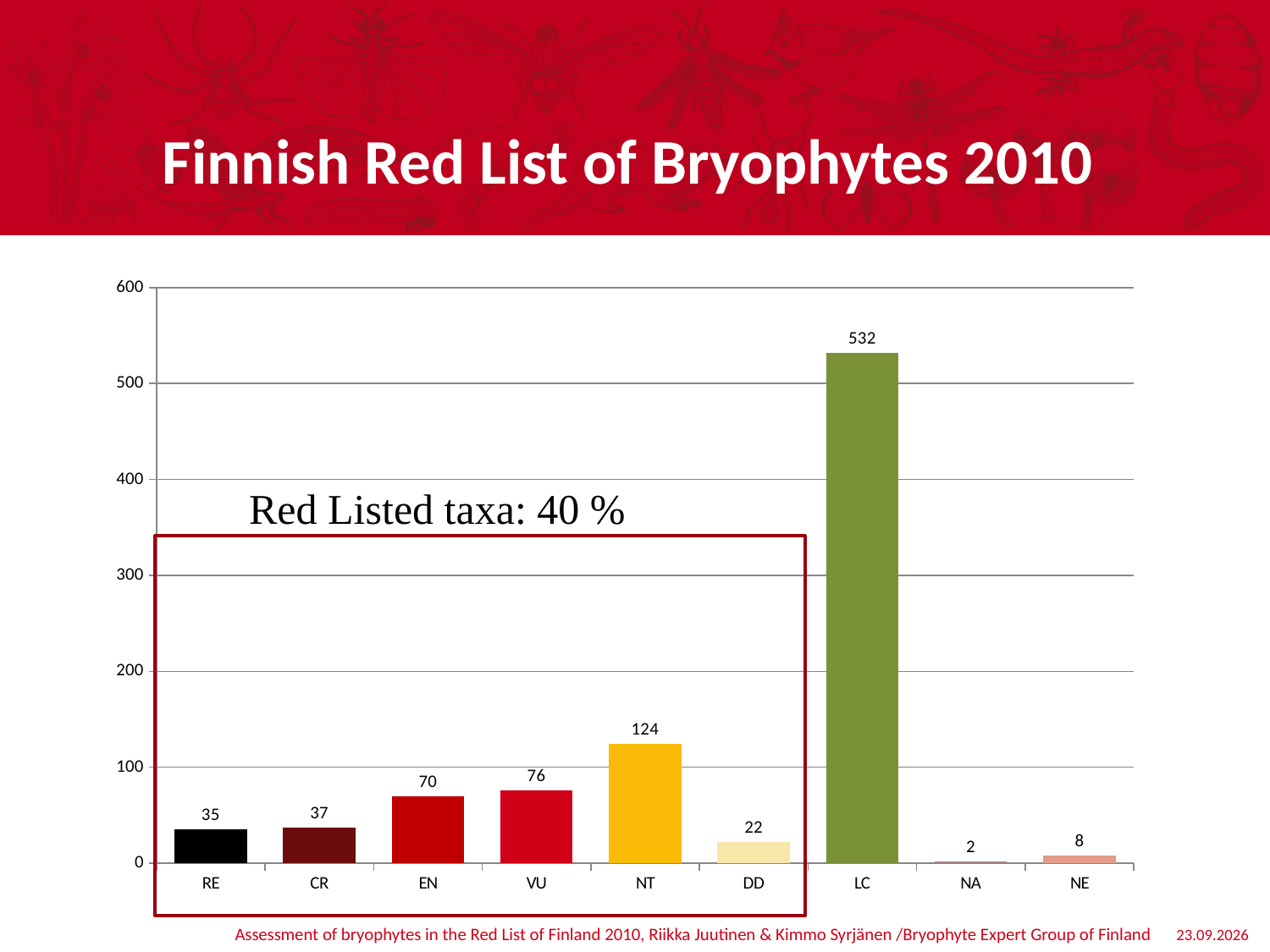
How many categories are shown on the x axis? 9 What is the difference between the values for VU and EN? 6 Which is larger, the value for CR or the value for RE? CR Which category has the highest value? LC What is the value for NT? 124 What percentage of taxa does the text box on the chart say are Red Listed? 40 % Is the value for LC greater or less than 500? greater Which category has the lowest value? NA What is the difference between the values for LC and NT? 408 What is the value for LC? 532 What is the value for DD? 22 What kind of chart is shown on the slide? bar chart